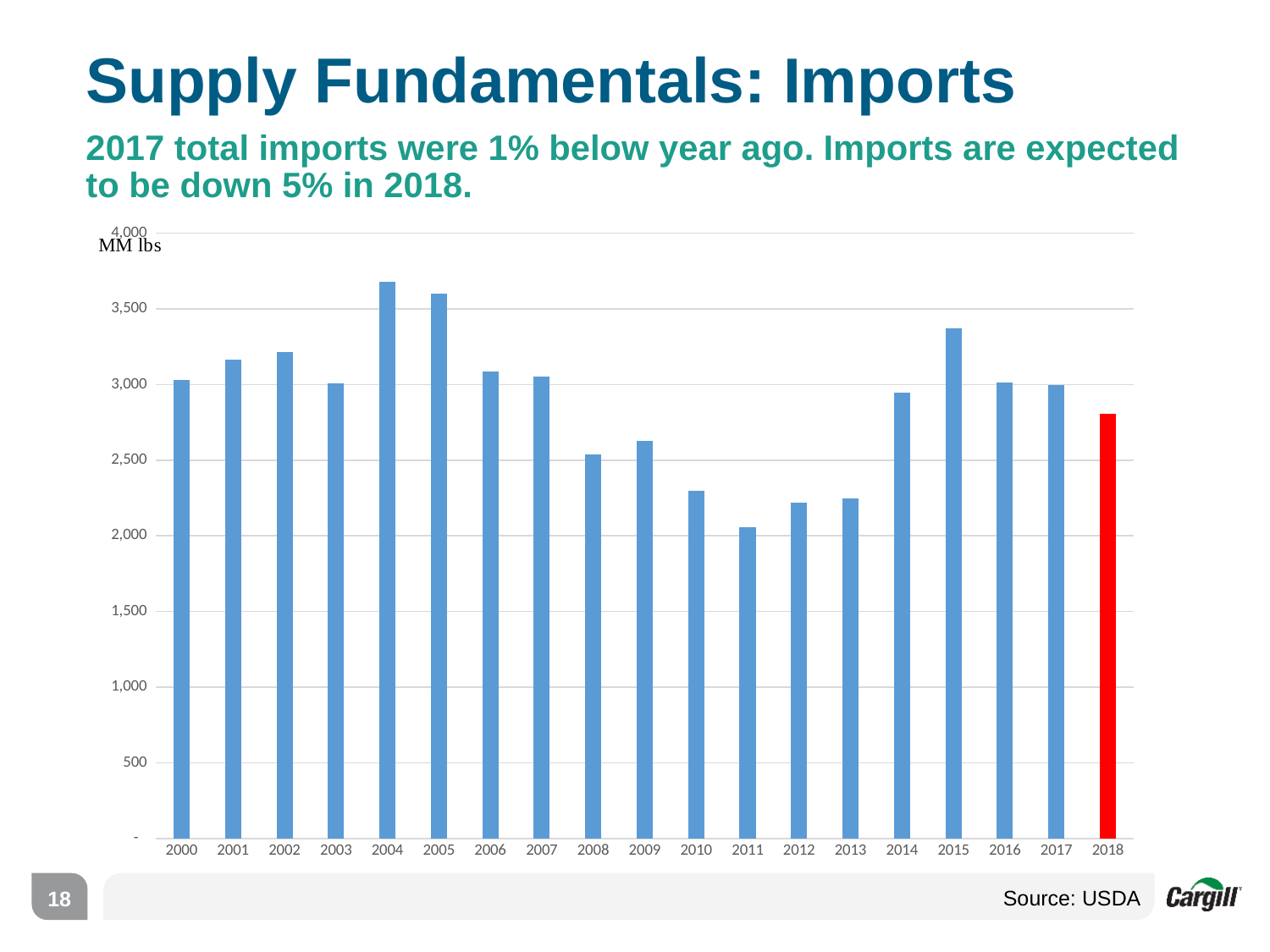
Is the value for 2018 greater or less than 3,000? less Which year's bar is coloured red instead of blue? 2018 Is the value for 2004 greater or less than 3,500? greater Is the value for 2015 greater or less than 3,500? less What kind of chart is shown on the slide? bar chart How many years are plotted on the x axis? 19 Which year has the larger value, 2014 or 2015? 2015 Which year has the larger value, 2004 or 2005? 2004 Which year has the highest imports in the chart? 2004 Which year has the lowest imports in the chart? 2011